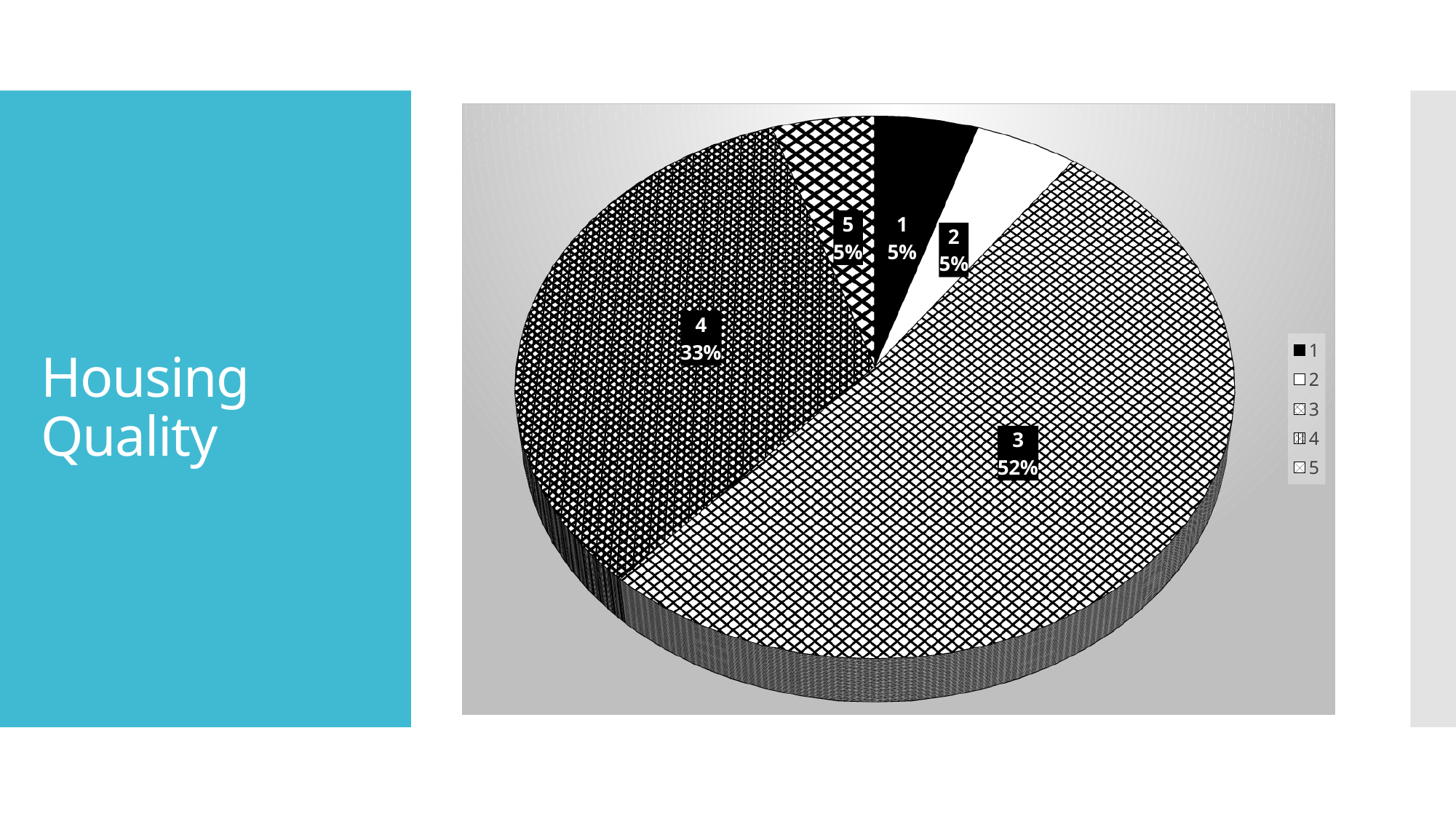
What share of the pie does category 5 represent? 5% What share of the pie does category 1 represent? 5% What is the difference in percentage points between the shares of category 3 and category 4? 19 What share of the pie does category 3 represent? 52% What kind of chart is shown on the slide? pie chart What is the combined share of categories 3 and 4? 85% How many slices does the pie chart have? 5 What is the title text shown on the left of the slide? Housing Quality Which slice is larger, category 4 or category 2? 4 Which category has the largest slice of the pie? 3 How many entries does the legend list? 5